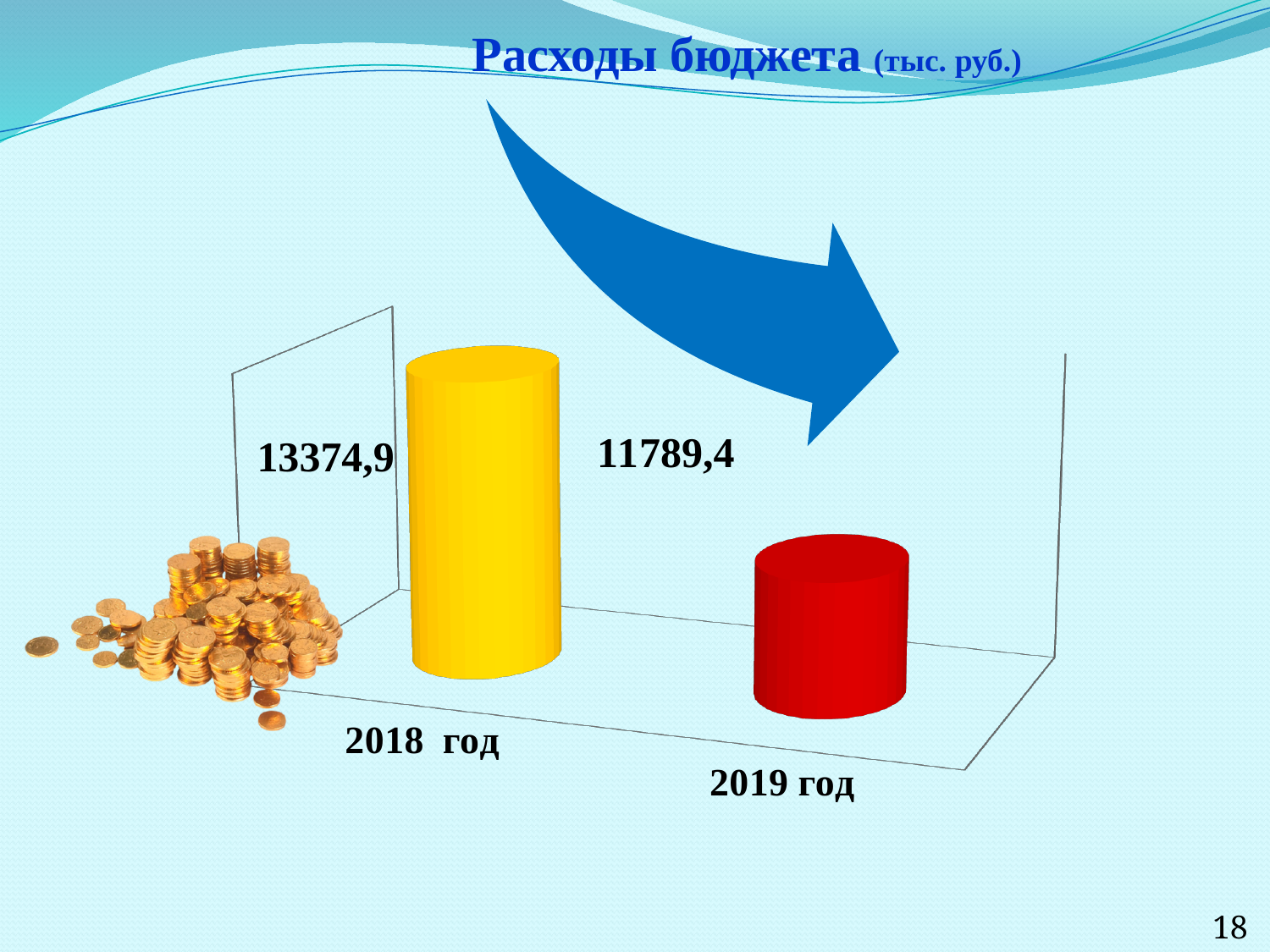
What kind of chart is shown on the slide? bar chart What is the title of the chart? Расходы бюджета (тыс. руб.) Which year has the lowest value? 2019 год What is the value for 2018 год? 13374,9 How many categories are shown in the chart? 2 What colour is the bar for 2019 год? red Do the values rise or fall from 2018 год to 2019 год? fall Which is larger, the value for 2018 год or for 2019 год? 2018 год What is the value for 2019 год? 11789,4 What is the difference between the values for 2018 год and 2019 год? 1585,5 Which year has the highest value? 2018 год